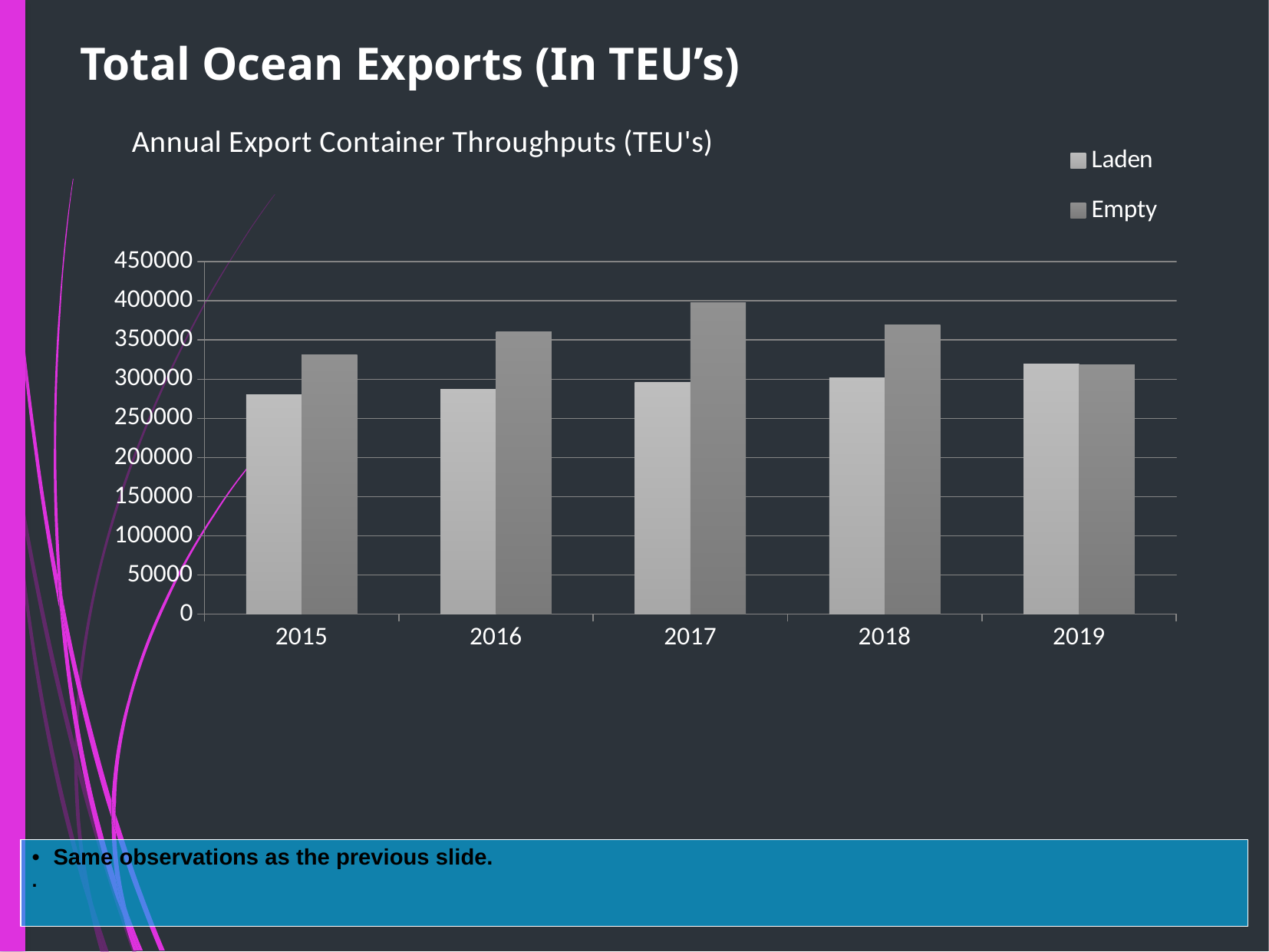
Which year has the highest Empty value? 2017 How many series does the legend list? 2 Is the Empty value for 2015 greater or less than 350000? less How many years are shown on the x axis? 5 What is the title of the chart? Annual Export Container Throughputs (TEU's) Which year has the highest Laden value? 2019 What kind of chart is shown on the slide? bar chart Which year has the lowest Empty value? 2019 In 2017, which is larger, Laden or Empty? Empty Do the Laden values rise or fall from 2015 to 2019? rise Is the Empty value for 2017 greater or less than 350000? greater Is the Laden value for 2016 greater or less than 300000? less